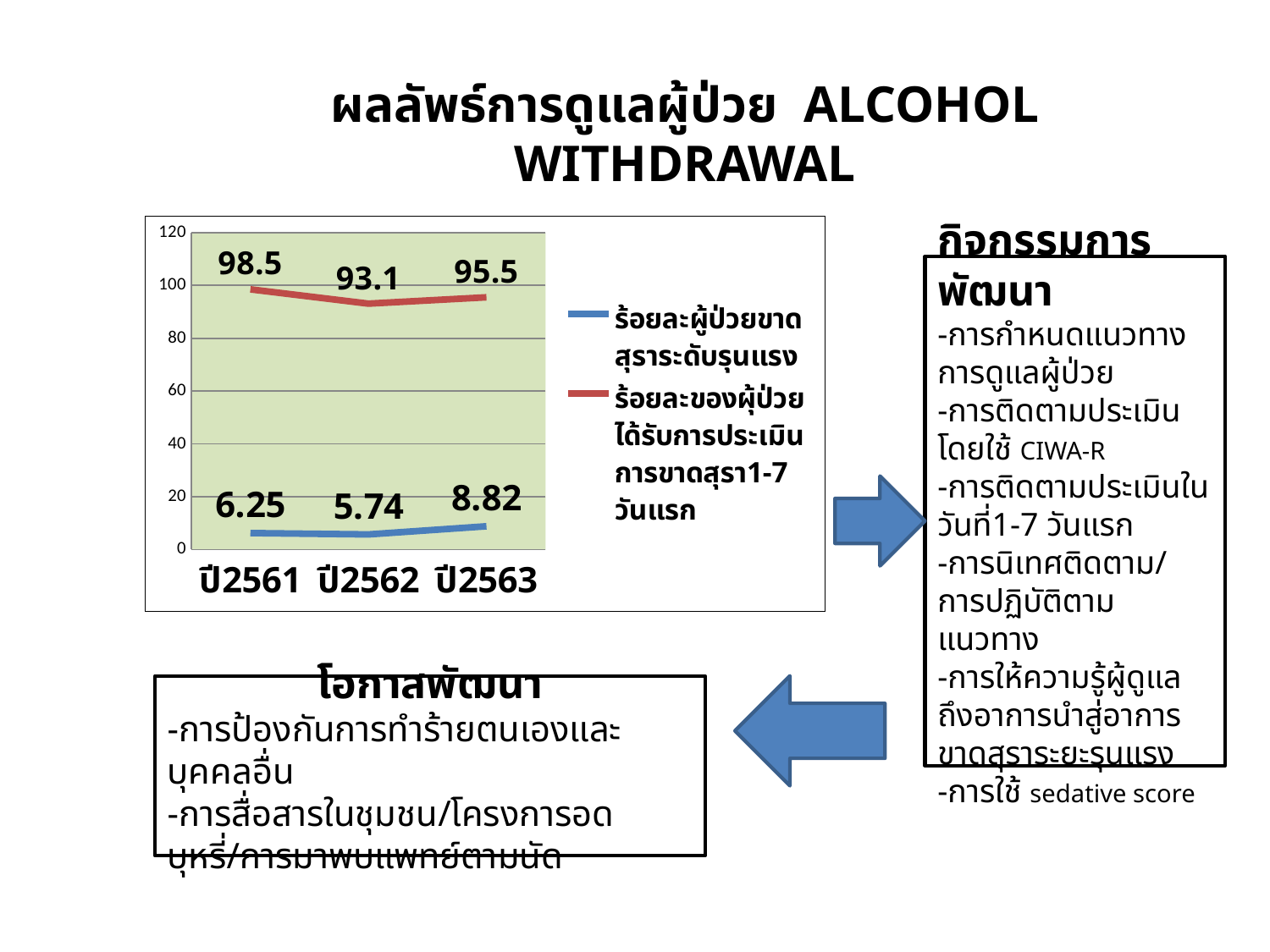
What is the difference between the ร้อยละของผู้ป่วยได้รับการประเมินการขาดสุรา1-7 วันแรก values for ปี2561 and ปี2562? 5.4 How many series does the chart legend list? 2 What type of chart is shown on the slide? line chart Which is larger: ร้อยละผู้ป่วยขาดสุราระดับรุนแรง in ปี2563 or in ปี2561? ปี2563 What is the value of ร้อยละผู้ป่วยขาดสุราระดับรุนแรง for ปี2561? 6.25 What is the value of ร้อยละของผู้ป่วยได้รับการประเมินการขาดสุรา1-7 วันแรก for ปี2562? 93.1 In which year is ร้อยละของผู้ป่วยได้รับการประเมินการขาดสุรา1-7 วันแรก highest? ปี2561 What is the value of ร้อยละผู้ป่วยขาดสุราระดับรุนแรง for ปี2563? 8.82 Is the value of ร้อยละของผู้ป่วยได้รับการประเมินการขาดสุรา1-7 วันแรก for ปี2563 greater or less than 80? greater In which year is ร้อยละผู้ป่วยขาดสุราระดับรุนแรง lowest? ปี2562 Which colour is used for the ร้อยละผู้ป่วยขาดสุราระดับรุนแรง line? blue How many years are plotted on the x axis of the chart? 3